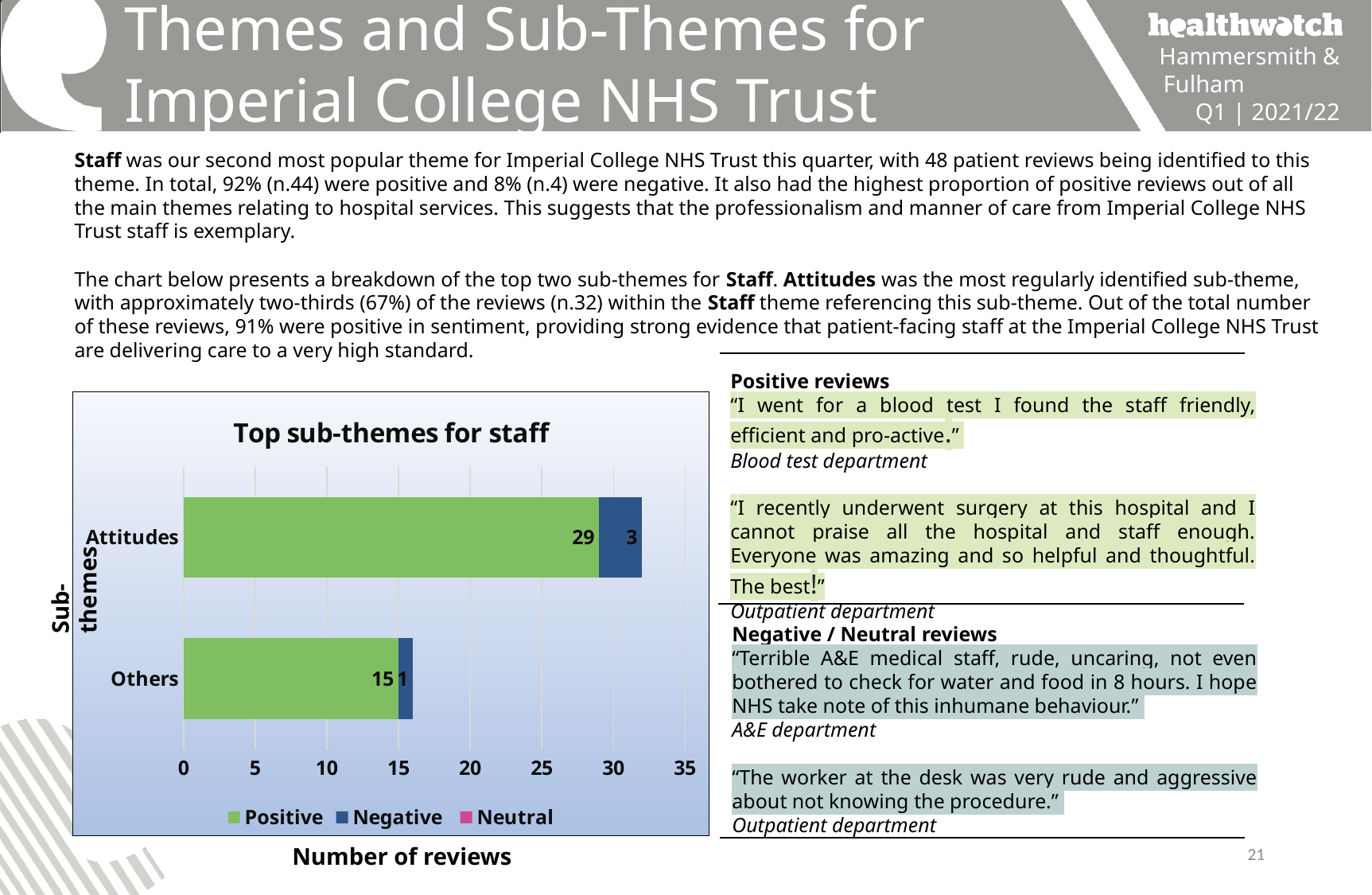
What is the number of Positive reviews for Attitudes? 29 What is the number of Negative reviews for Others? 1 What is the number of Positive reviews for Others? 15 What is the total number of reviews in the Attitudes bar? 32 What is the number of Negative reviews for Attitudes? 3 How many sub-theme categories are plotted in the chart? 2 What is the title of the chart? Top sub-themes for staff What is the difference between the Positive reviews for Attitudes and for Others? 14 What type of chart is shown on the slide? bar chart Which sub-theme has the higher number of Positive reviews, Attitudes or Others? Attitudes How many series does the chart legend list? 3 What is the total number of reviews in the Others bar? 16